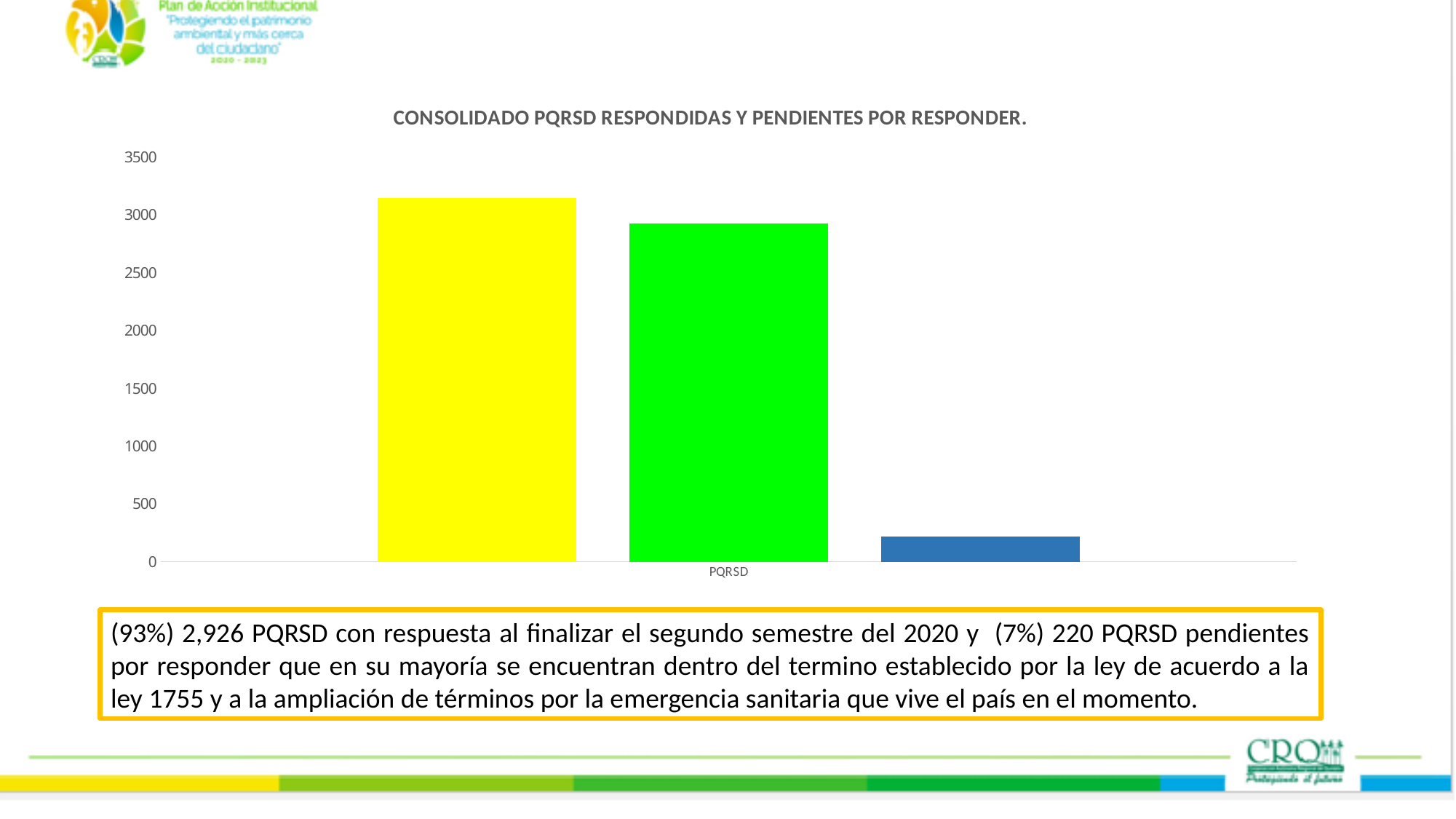
What is the category label shown on the x axis of the chart? PQRSD Is the value of the yellow bar greater or less than 3000? greater Which is larger, the green bar or the blue bar? the green bar Which bar is the shortest in the chart? the blue bar Is the value of the green bar greater or less than 2500? greater Which is larger, the yellow bar or the green bar? the yellow bar How many bars are plotted in the chart? 3 What is the title of the chart? CONSOLIDADO PQRSD RESPONDIDAS Y PENDIENTES POR RESPONDER. Which bar is the tallest in the chart? the yellow bar What kind of chart is shown on the slide? bar chart Is the value of the green bar greater or less than 3000? less